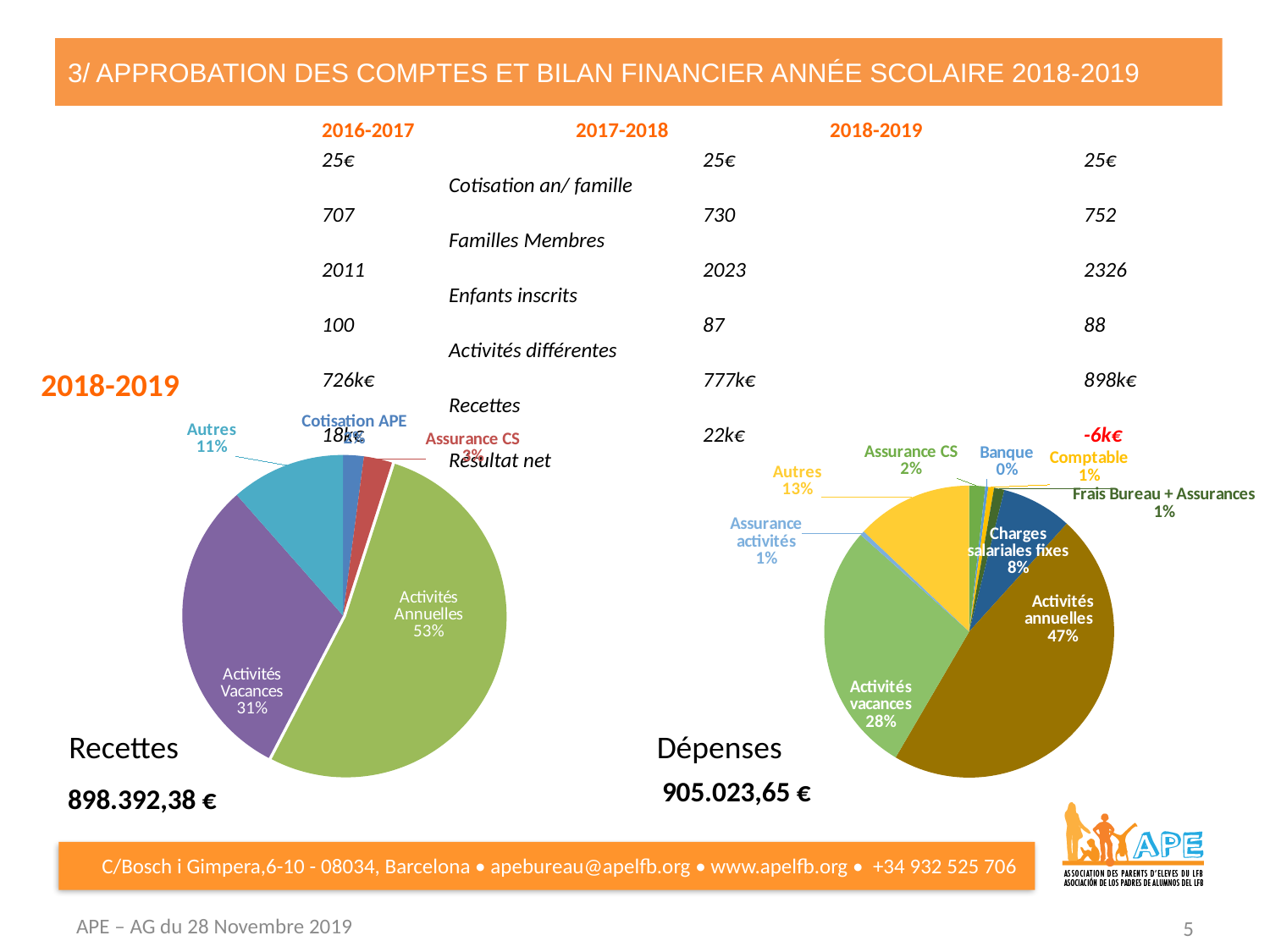
In the Dépenses pie chart, what share is Autres? 13% In the Recettes pie chart, what share is Autres? 11% In the Dépenses pie chart, what share is Charges salariales fixes? 8% In the Dépenses pie chart, which is larger: Autres or Charges salariales fixes? Autres What kind of chart is the Recettes chart on the left? pie chart In the Recettes pie chart, what share is Activités Annuelles? 53% In the Recettes pie chart, what share is Activités Vacances? 31% How many categories are shown in the Dépenses pie chart? 9 In the Dépenses pie chart, what share is Activités vacances? 28% In the Recettes pie chart, how many percentage points larger is Activités Annuelles than Activités Vacances? 22 In the Recettes pie chart, which category has the largest share? Activités Annuelles In the Dépenses pie chart, what share is Activités annuelles? 47%